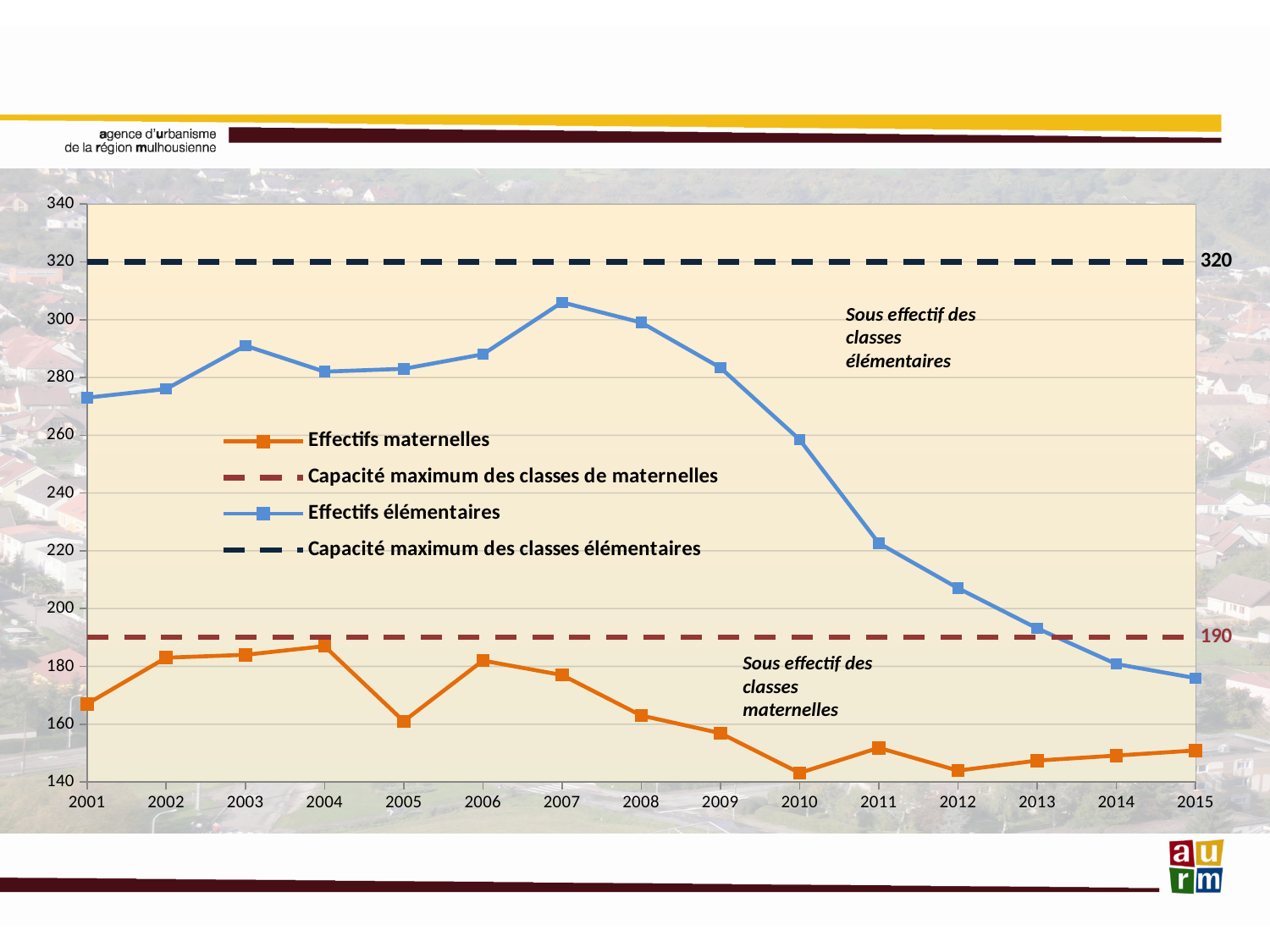
How many years are shown on the x axis? 15 In which year is the Effectifs élémentaires series at its highest? 2007 In which year is the Effectifs élémentaires series at its lowest? 2015 How many entries does the legend list? 4 Is the value for Effectifs élémentaires in 2007 greater or less than 300? greater Is the value for Effectifs élémentaires in 2011 greater or less than 240? less Is the value for Effectifs maternelles in 2005 greater or less than 180? less What value is shown for the Capacité maximum des classes élémentaires line? 320 What kind of chart is shown on the slide? line chart What value is shown for the Capacité maximum des classes de maternelles line? 190 Which is larger in 2001, Effectifs élémentaires or Effectifs maternelles? Effectifs élémentaires Does the Effectifs élémentaires series rise or fall from 2007 to 2015? fall